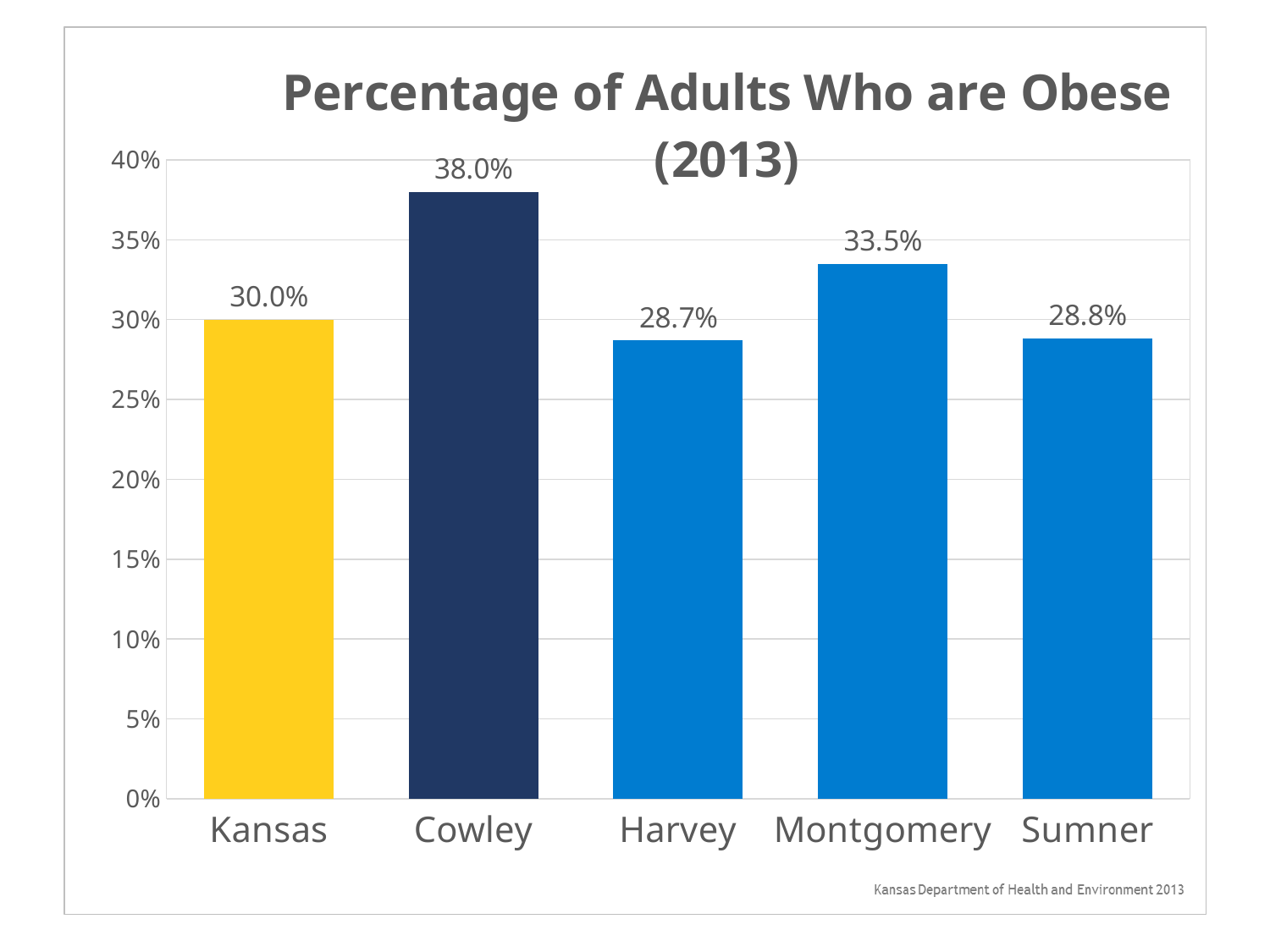
What is the difference between the values for Cowley and Kansas? 8.0% What is the value shown for Montgomery? 33.5% What is the value shown for Harvey? 28.7% Which category has the lowest percentage of obese adults? Harvey What kind of chart is shown on the slide? Bar chart What is the percentage of adults who are obese in Cowley? 38.0% How many categories are shown on the chart? 5 What is the difference between the values for Montgomery and Sumner? 4.7% Which has a higher percentage of obese adults, Montgomery or Harvey? Montgomery What is the percentage of adults who are obese in Kansas? 30.0% Which category has the highest percentage of obese adults? Cowley Is the value for Sumner greater or less than 30%? less